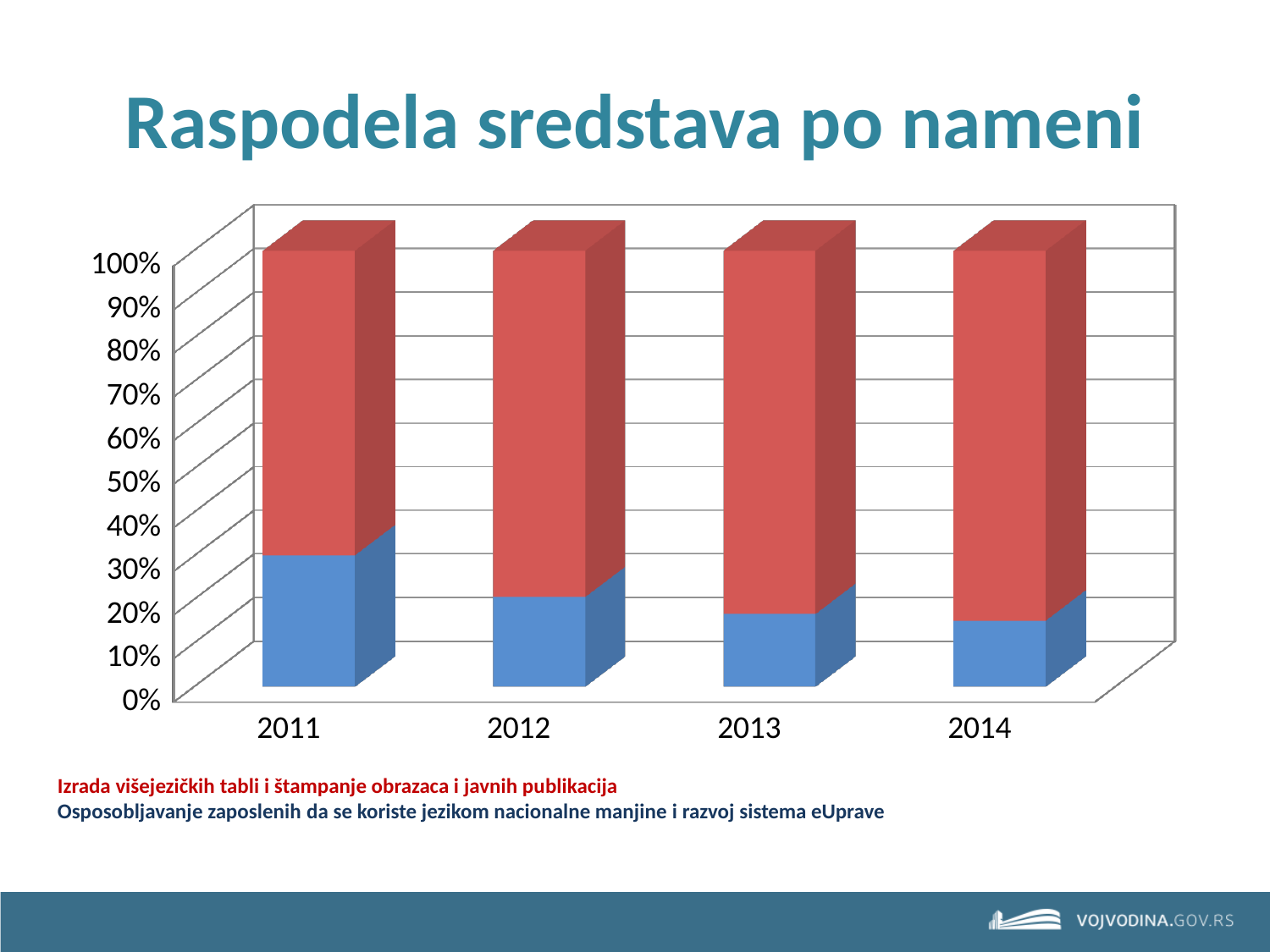
What is the total of the stacked bar for 2012? 100% Which colour represents 'Izrada višejezičkih tabli i štampanje obrazaca i javnih publikacija' in the chart? Red How many years are shown on the x axis of the chart? 4 Which year has the largest blue (bottom) segment in the chart? 2011 Is the blue (bottom) segment for 2011 greater or less than 20%? greater Does the blue (bottom) segment rise or fall from 2011 to 2014? Fall What kind of chart is shown on the slide? Stacked bar chart Which year has the larger blue (bottom) segment, 2011 or 2013? 2011 What is the title of the chart on the slide? Raspodela sredstava po nameni Is the blue (bottom) segment for 2012 greater or less than 30%? less Is the blue (bottom) segment for 2014 greater or less than 30%? less